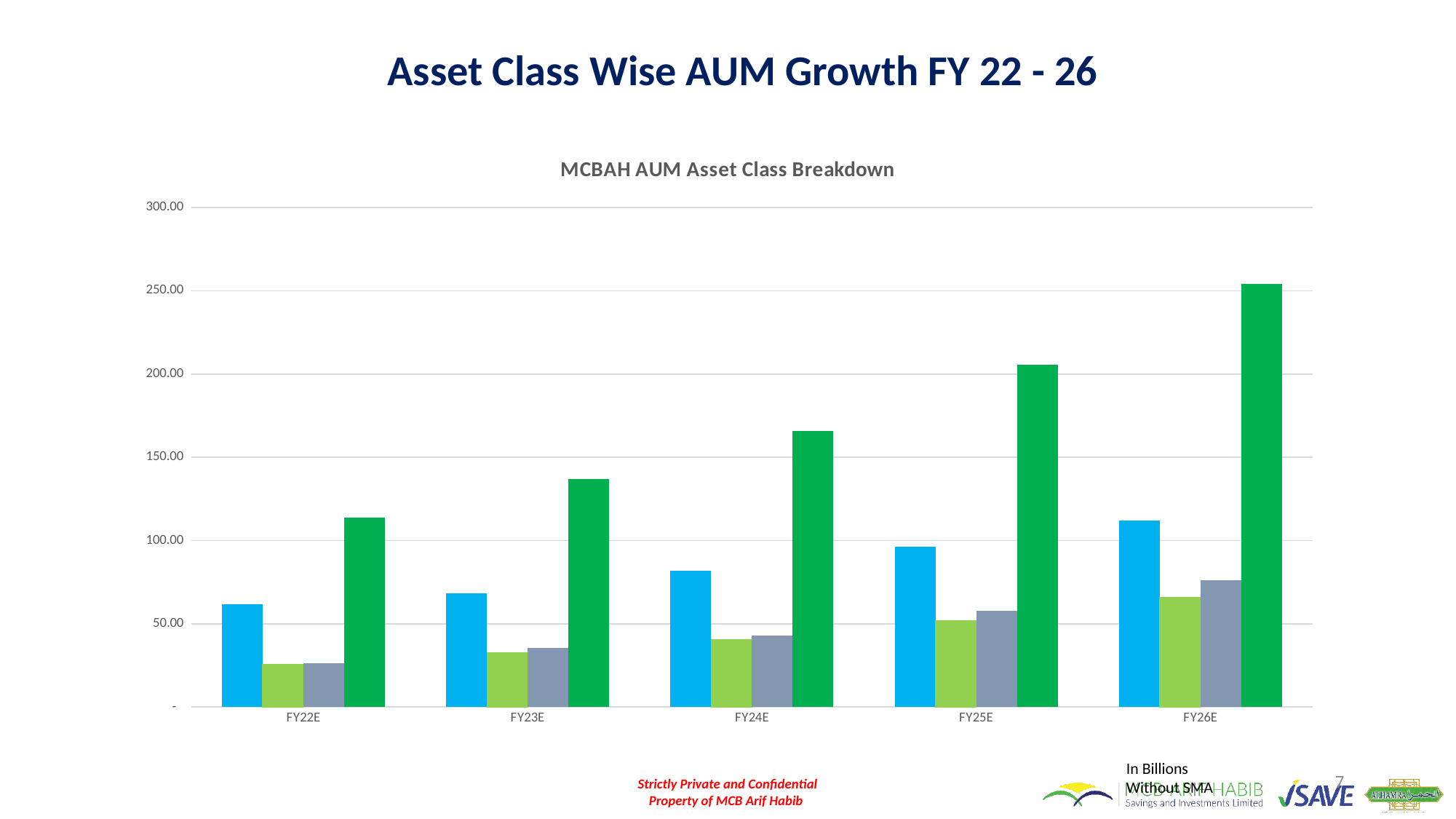
Do the dark green bars rise or fall from FY22E to FY26E? rise How many fiscal year categories are shown on the x axis? 5 In which fiscal year is the dark green bar the tallest? FY26E What is the title of the chart? MCBAH AUM Asset Class Breakdown Is the grey bar for FY26E greater or less than 50.00? greater How many bars are plotted for each fiscal year category? 4 What kind of chart is shown on the slide? bar chart Is the blue bar for FY26E greater or less than 100.00? greater For FY26E, which is larger: the dark green bar or the blue bar? the dark green bar In which fiscal year is the blue bar the shortest? FY22E Is the dark green bar for FY24E greater or less than 150.00? greater